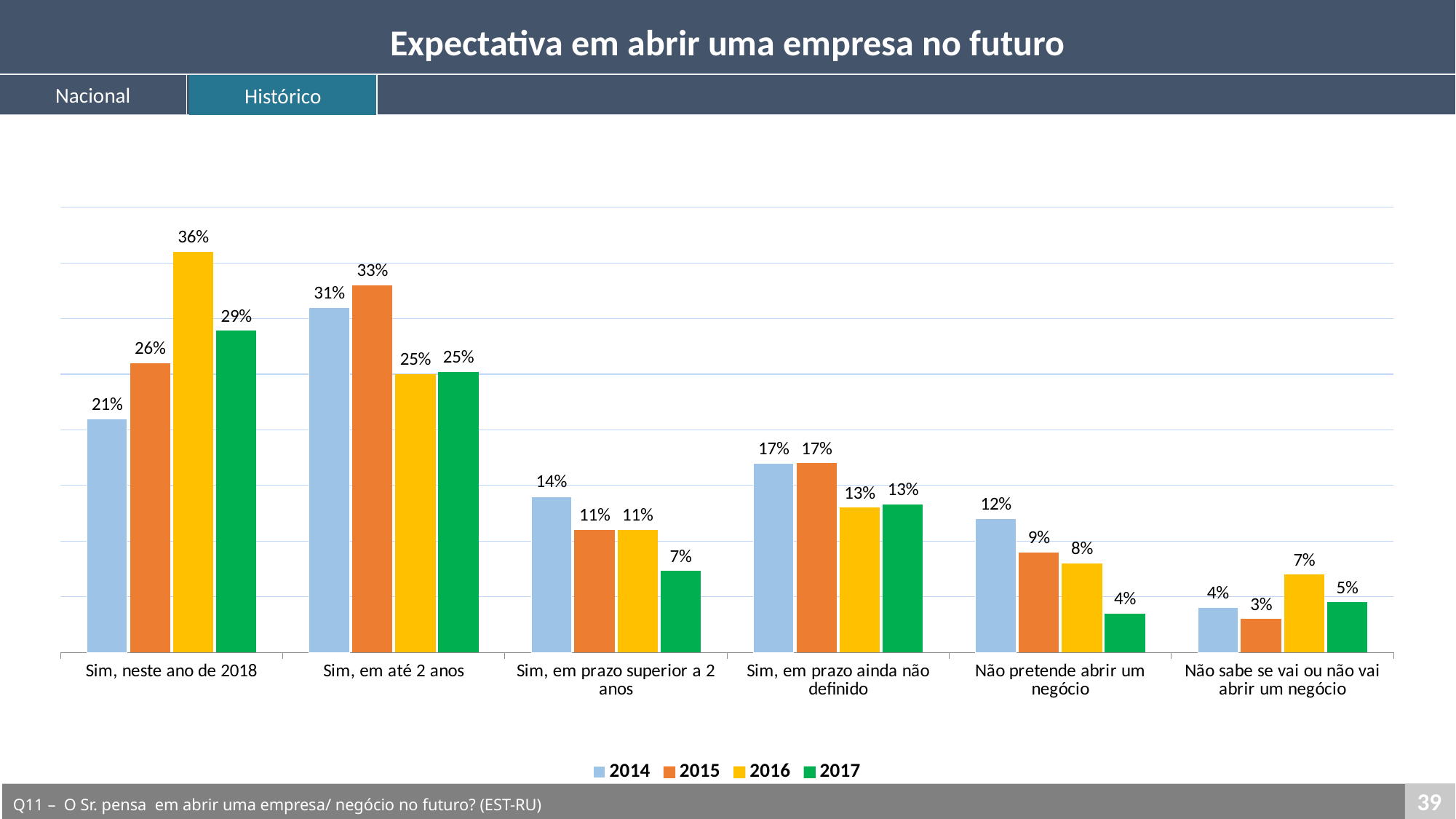
What is the difference between the 2016 and 2014 values in the category "Sim, neste ano de 2018"? 15% Which year has the lowest value in the category "Não pretende abrir um negócio"? 2017 Which is larger in the category "Sim, em até 2 anos": the 2015 value or the 2017 value? 2015 What is the value for 2015 in the category "Não sabe se vai ou não vai abrir um negócio"? 3% What is the value for 2014 in the category "Sim, em até 2 anos"? 31% How many categories are shown on the x axis? 6 How many series does the legend list? 4 What is the value for 2017 in the category "Sim, em prazo superior a 2 anos"? 7% What kind of chart is shown on the slide? bar chart What is the value for 2016 in the category "Sim, neste ano de 2018"? 36% Which year has the highest value in the category "Sim, neste ano de 2018"? 2016